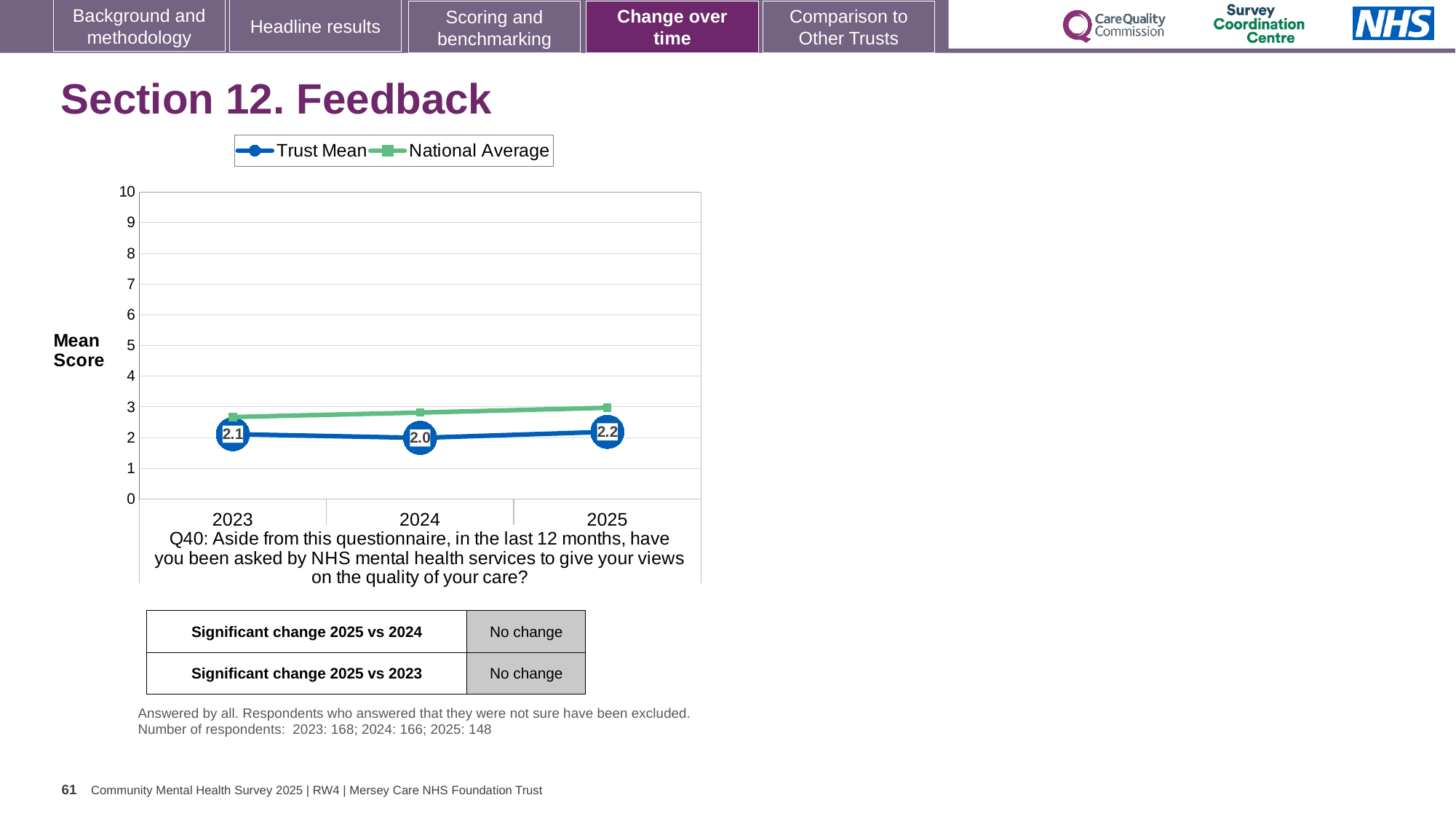
Which is higher in 2025, the Trust Mean or the National Average? National Average What is the Trust Mean score for 2025? 2.2 In which year is the Trust Mean score highest? 2025 Does the National Average line rise or fall from 2023 to 2025? rise What is the Trust Mean score for 2023? 2.1 Is the National Average value for 2025 greater or less than 4? less How many years are plotted on the x axis? 3 What kind of chart is shown on the slide? line chart What is the Trust Mean score for 2024? 2.0 How many series does the legend list? 2 What is the difference between the Trust Mean score in 2025 and in 2024? 0.2 In which year is the Trust Mean score lowest? 2024